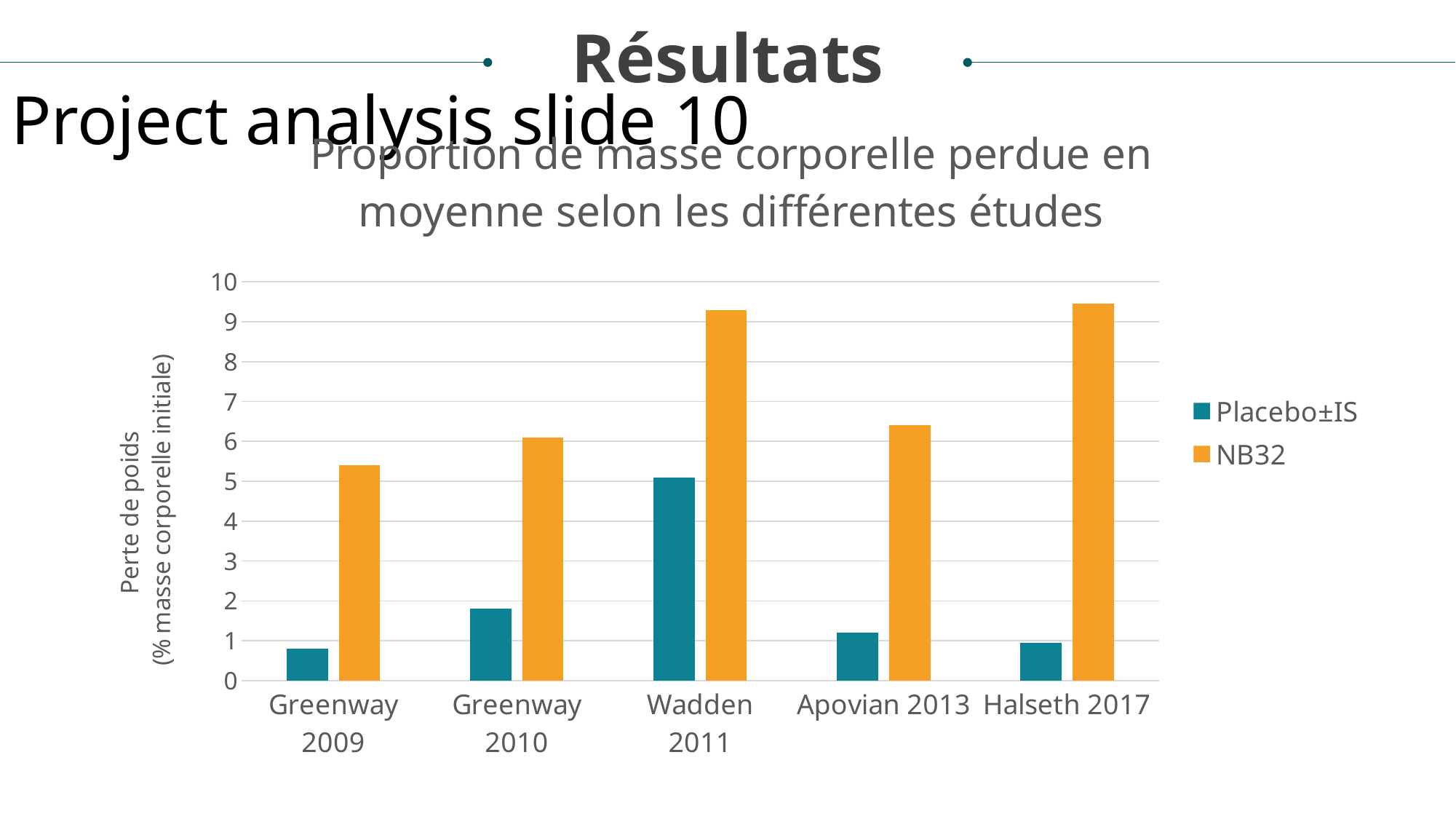
Is the NB32 value for Wadden 2011 greater or less than 9? greater For Halseth 2017, which series has the larger value, Placebo±IS or NB32? NB32 Is the Placebo±IS value for Greenway 2010 greater or less than 2? less Is the NB32 value for Apovian 2013 greater or less than 6? greater What colour are the NB32 bars in the chart? orange What kind of chart is shown on the slide? bar chart Which is larger: the Placebo±IS value for Wadden 2011 or the Placebo±IS value for Greenway 2010? Wadden 2011 How many studies are shown on the x axis of the chart? 5 Which study has the lowest NB32 value? Greenway 2009 Which study has the highest Placebo±IS value? Wadden 2011 How many series does the legend list? 2